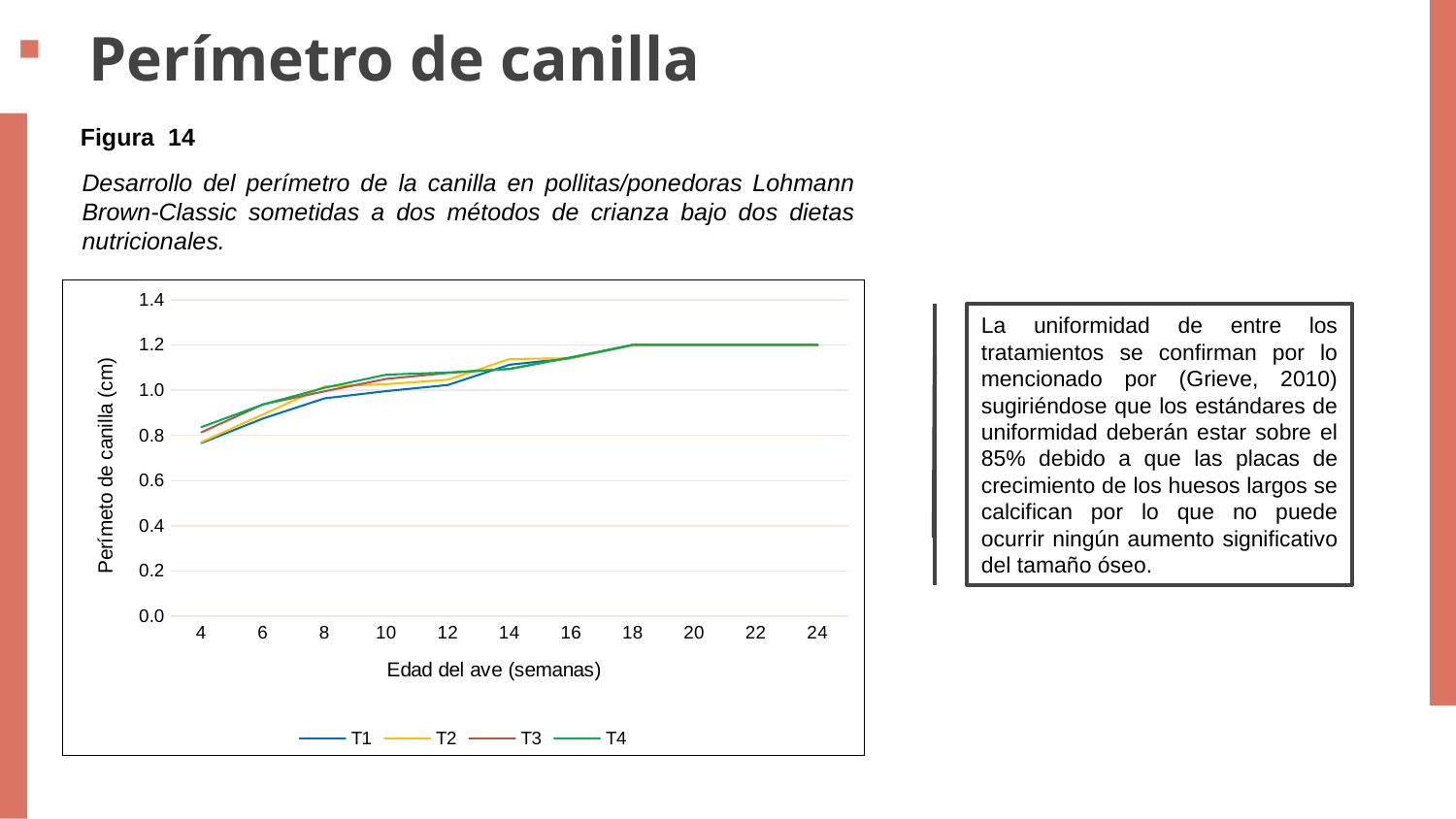
At week 4, which series has the higher value, T4 or T1? T4 Which series has the highest value at week 4? T4 What kind of chart is shown on the slide? line chart Is the value for T2 at week 16 greater or less than 1.4? less Is the value for T4 at week 24 greater or less than 1.0? greater Is the value for T1 at week 4 greater or less than 1.0? less How many series does the legend of the chart list? 4 How many age values (weeks) are labelled on the x axis of the chart? 11 What is the title of the x axis of the chart? Edad del ave (semanas) What are the series names listed in the chart legend? T1, T2, T3, T4 Do the values of the lines rise or fall as the age of the bird increases along the x axis? rise